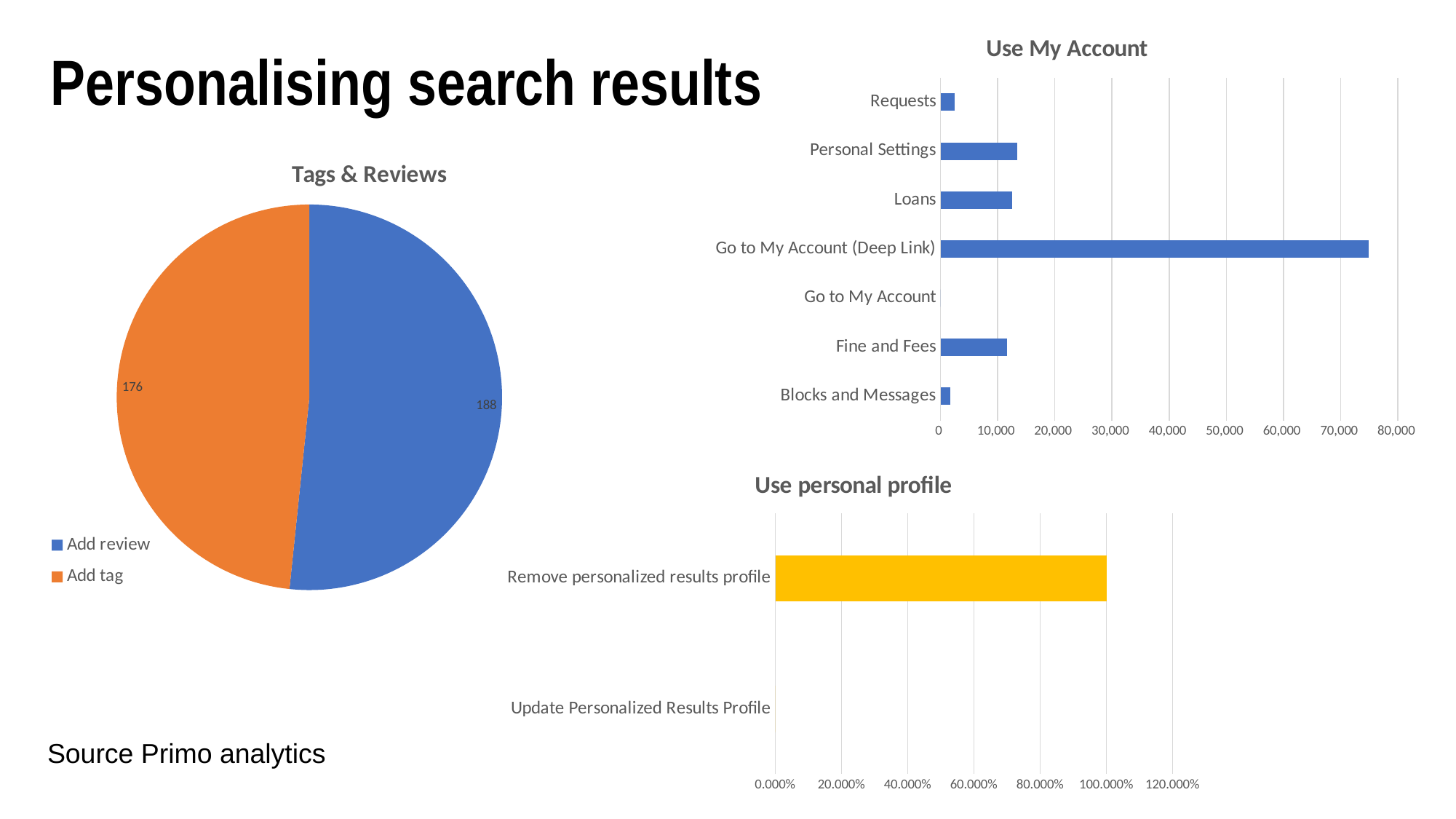
In the 'Use My Account' chart, is the value for Go to My Account (Deep Link) greater or less than 70,000? greater In the 'Tags & Reviews' chart, what is the value for Add review? 188 How many entries does the legend of the 'Tags & Reviews' chart list? 2 What kind of chart is 'Use My Account'? Bar chart In the 'Use personal profile' chart, which category has the higher value, Remove personalized results profile or Update Personalized Results Profile? Remove personalized results profile How many categories are shown in the 'Use My Account' chart? 7 In the 'Use My Account' chart, which category has the highest value? Go to My Account (Deep Link) In the 'Tags & Reviews' chart, what is the difference between Add review and Add tag? 12 In the 'Tags & Reviews' chart, what is the value for Add tag? 176 What kind of chart is 'Tags & Reviews'? Pie chart In the 'Use My Account' chart, is the value for Requests greater or less than 10,000? less In the 'Tags & Reviews' chart, which slice is larger, Add review or Add tag? Add review